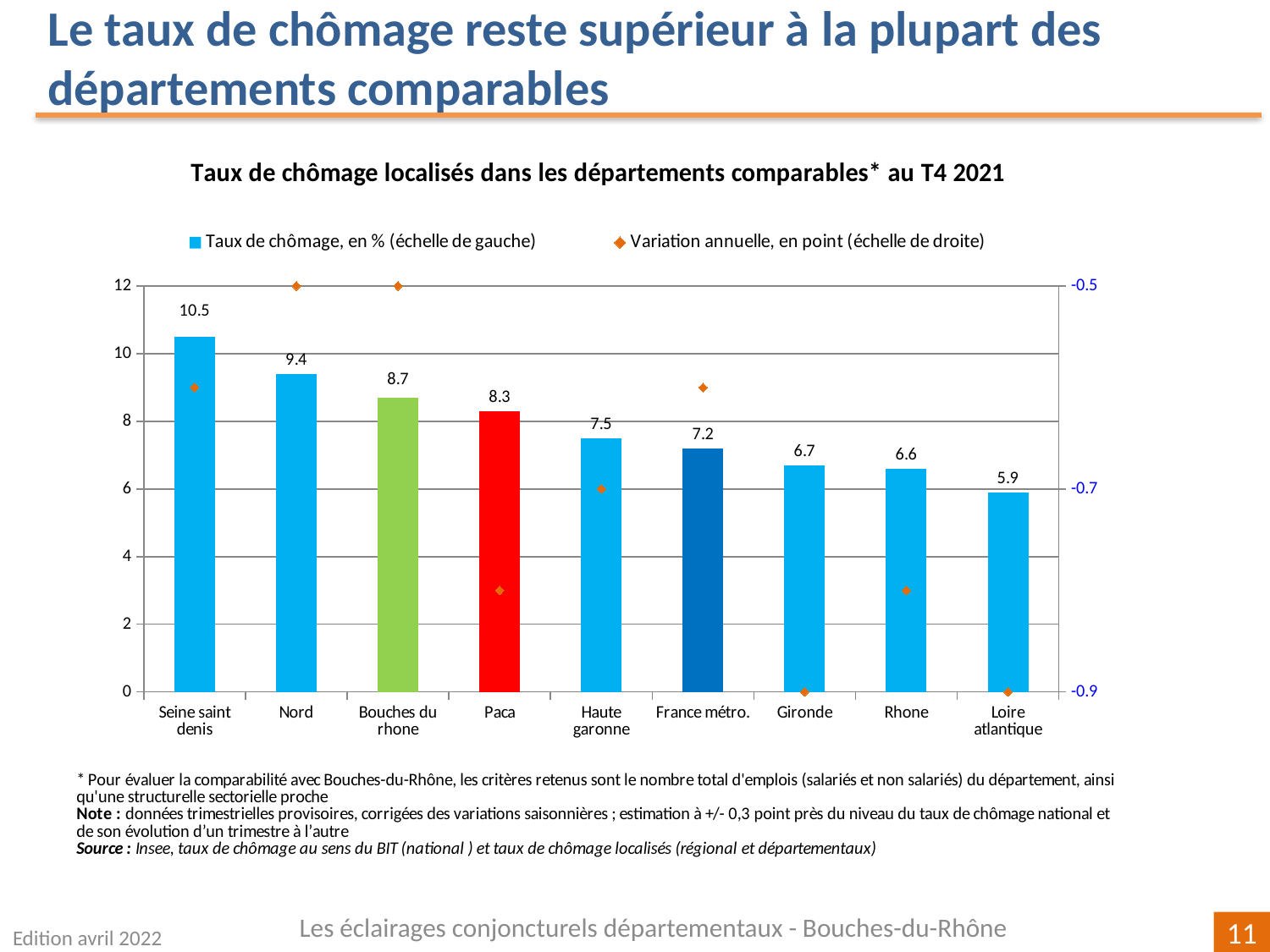
Is the annual variation (variation annuelle) for Paca greater or less than -0.7? less How many series does the legend list? 2 Which category has the highest unemployment rate? Seine saint denis Which category has the lowest unemployment rate? Loire atlantique What is the unemployment rate shown for Bouches du rhone? 8.7 What is the difference between the unemployment rates of Bouches du rhone and France métro.? 1.5 Which has a higher unemployment rate, Paca or Haute garonne? Paca What is the unemployment rate (taux de chômage) shown for Seine saint denis? 10.5 Is the annual variation for Seine saint denis greater or less than -0.7? greater What is the unemployment rate shown for France métro.? 7.2 What kind of chart is used to show the unemployment rate? bar chart How many categories are shown on the x axis? 9